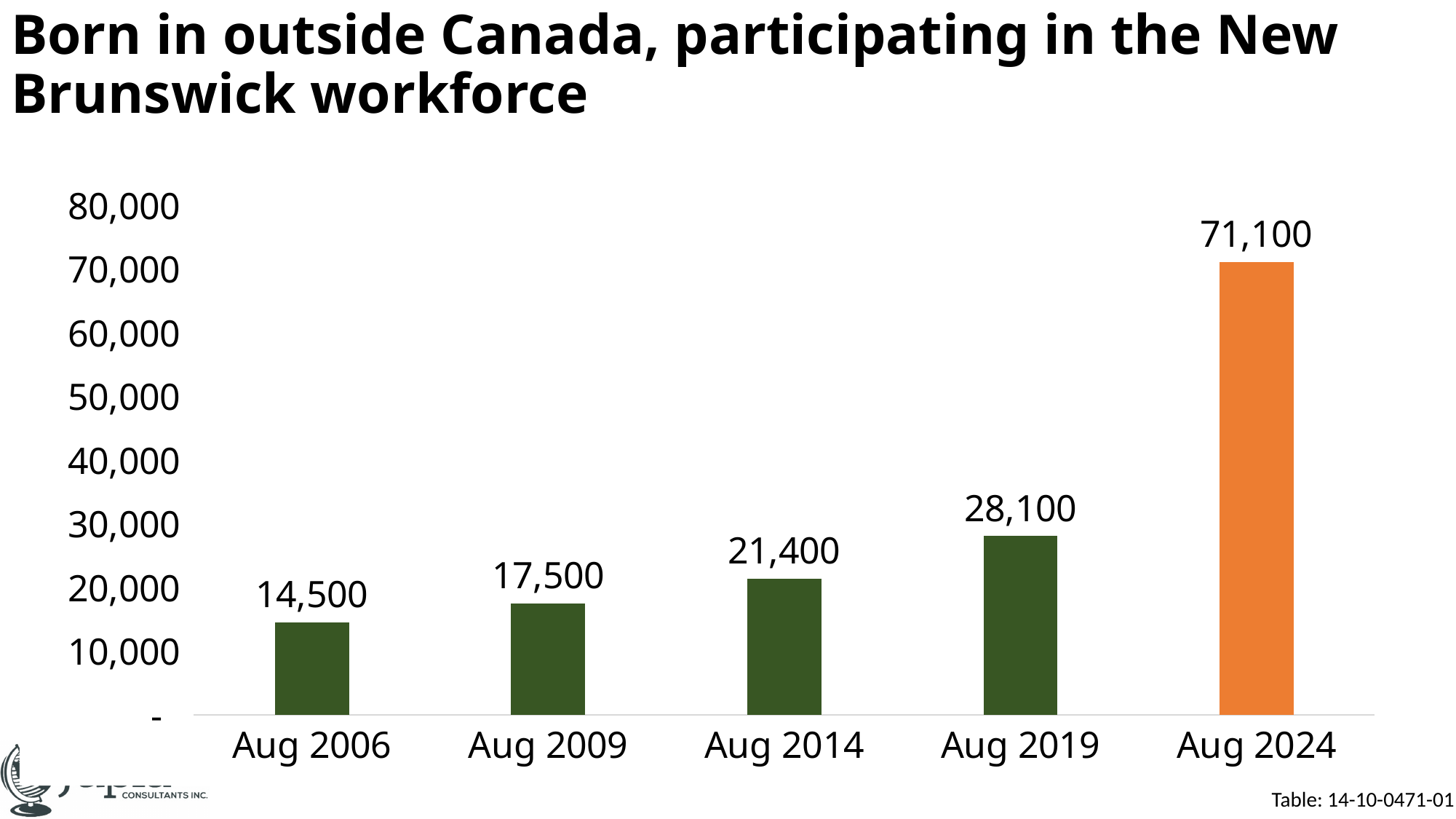
How many categories are shown on the x axis? 5 Is the value for Aug 2024 greater or less than 70,000? greater Which category has the lowest value? Aug 2006 What is the value for Aug 2014? 21,400 Which category has the highest value? Aug 2024 Which is larger, the value for Aug 2014 or the value for Aug 2019? Aug 2019 Do the values rise or fall from Aug 2006 to Aug 2024? rise What is the difference between the values for Aug 2024 and Aug 2019? 43,000 What is the value for Aug 2006? 14,500 What is the value for Aug 2024? 71,100 What is the difference between the values for Aug 2009 and Aug 2006? 3,000 What kind of chart is shown on the slide? bar chart